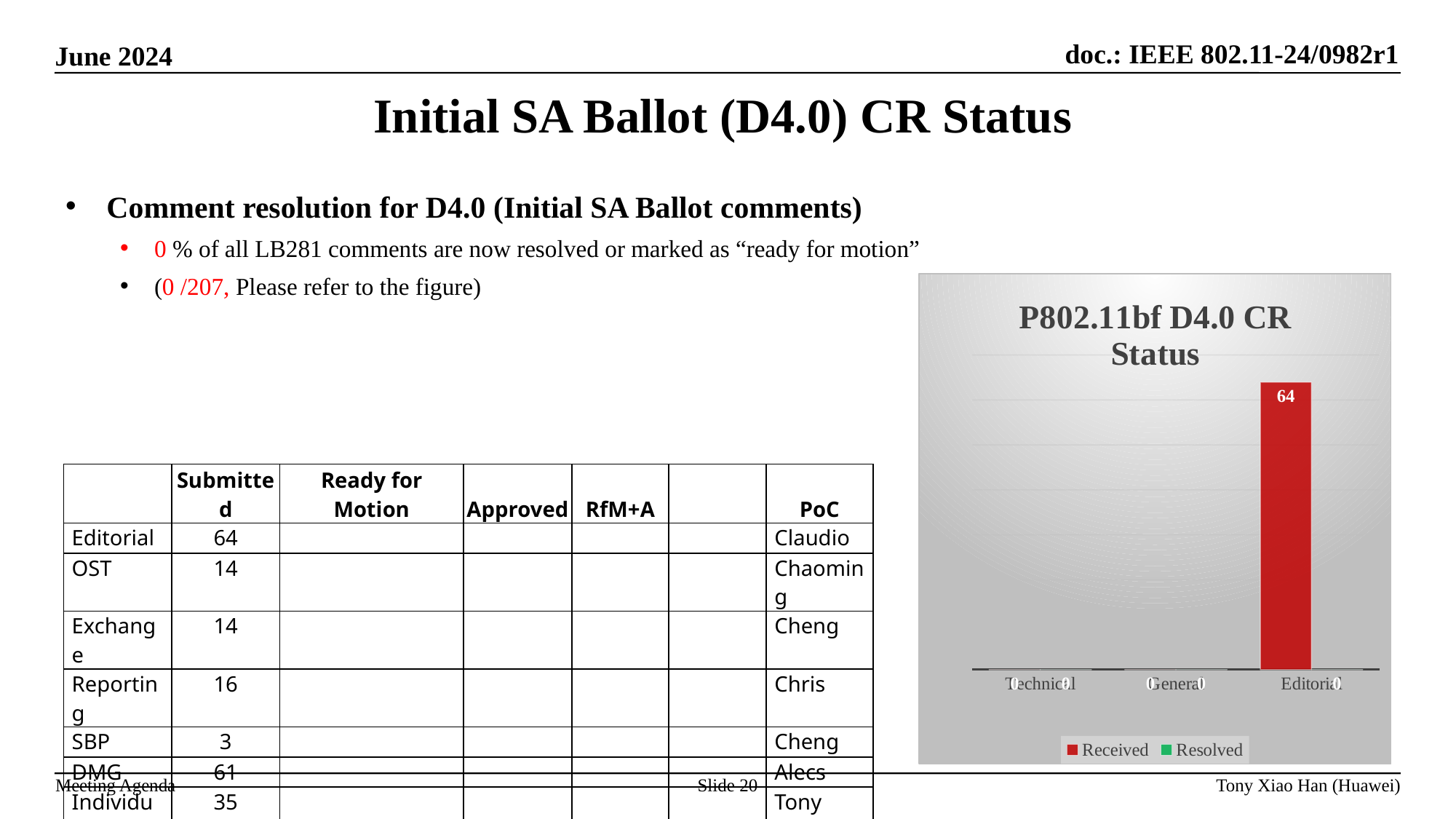
Which category has the highest Received value in the chart? Editorial How many series does the chart's legend list? 2 What are the two series named in the chart's legend? Received and Resolved What is the Received value for General in the chart? 0 What is the Received value for Editorial in the chart? 64 How many categories are shown on the x axis of the chart? 3 What kind of chart is shown on the slide? bar chart Which is larger in the chart, the Received value for Editorial or for Technical? Editorial What is the difference between the Received values for Editorial and Technical in the chart? 64 What is the Resolved value for Editorial in the chart? 0 What is the title of the chart? P802.11bf D4.0 CR Status What is the Received value for Technical in the chart? 0